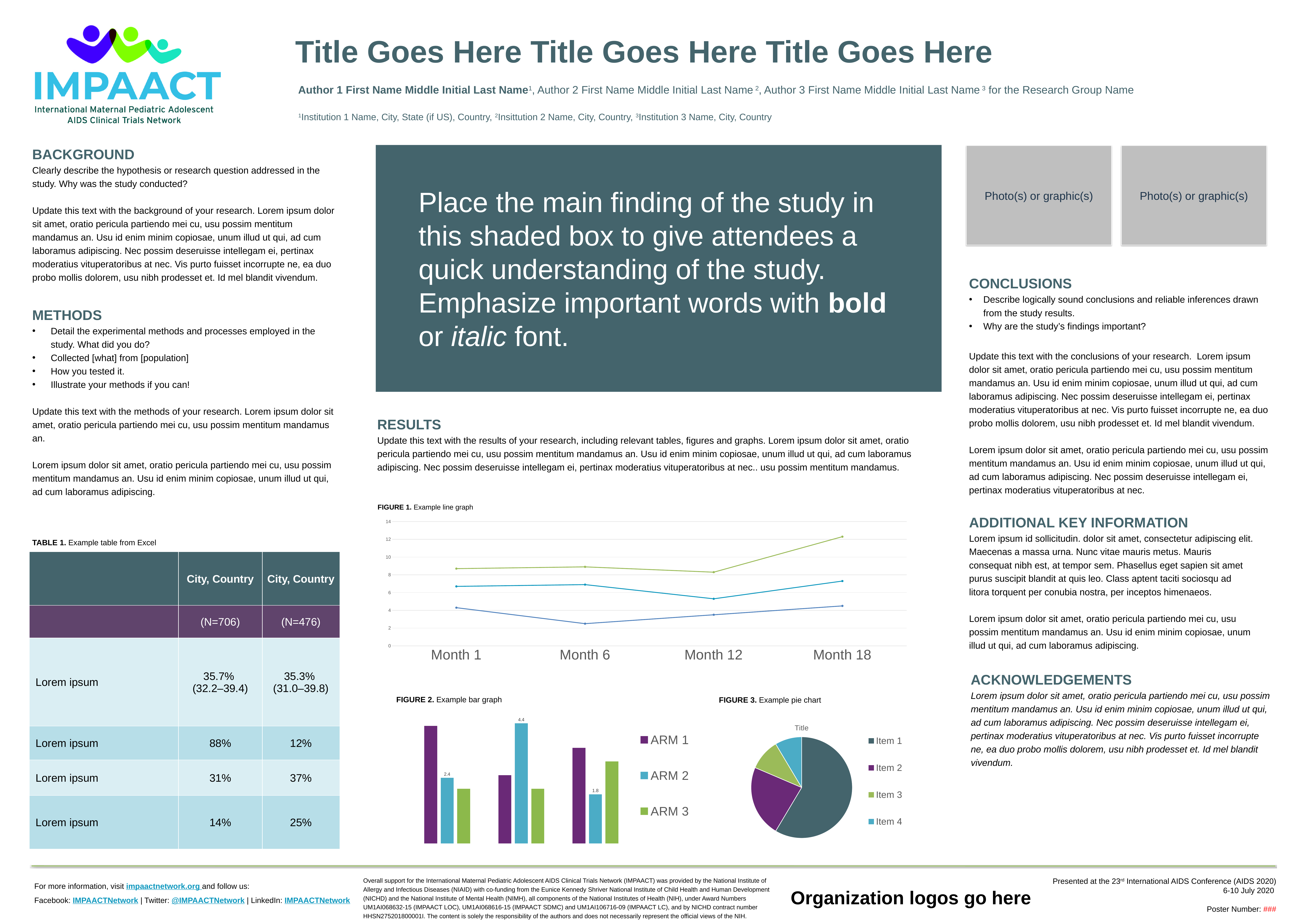
In Figure 3 (Example pie chart), which item has the largest slice? Item 1 In Figure 2 (Example bar graph), what is the highest labelled value for ARM 2? 4.4 What kind of chart is Figure 2 (Example bar graph)? bar chart In Figure 1 (Example line graph), how many lines are plotted? 3 In Figure 3 (Example pie chart), how many items does the legend list? 4 What kind of chart is Figure 1? line chart In Figure 2 (Example bar graph), how many series does the legend list? 3 In Figure 2 (Example bar graph), what is the difference between the highest and lowest labelled ARM 2 values? 2.6 In Figure 2 (Example bar graph), what is the lowest labelled value for ARM 2? 1.8 In Figure 2 (Example bar graph), what are the names of the series in the legend? ARM 1, ARM 2, ARM 3 What kind of chart is Figure 3? pie chart In Figure 1 (Example line graph), how many months are labelled on the x axis? 4